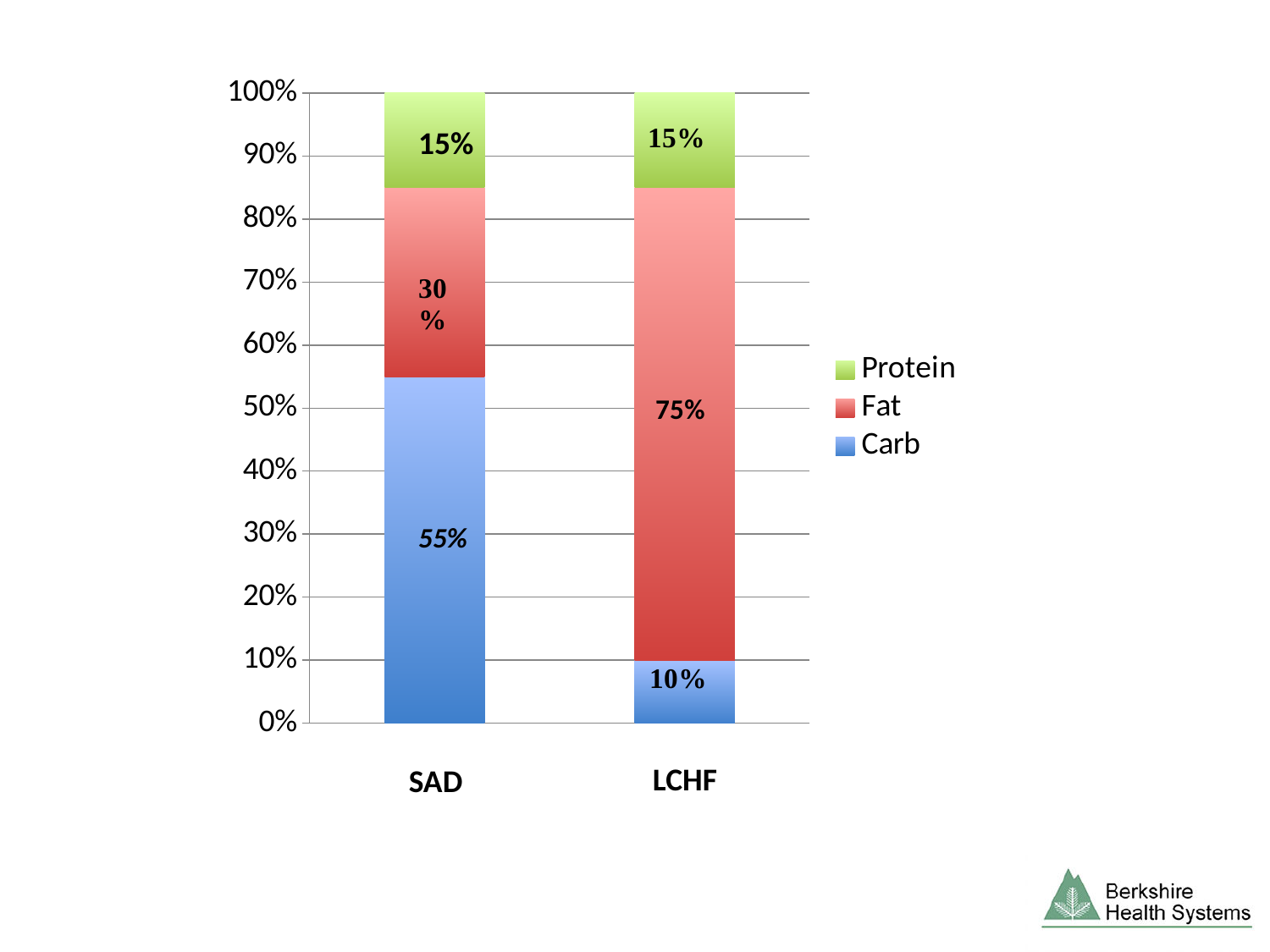
What is the Fat value for SAD? 30% What is the Carb value for SAD? 55% How many series does the legend list? 3 How many categories are shown on the x axis? 2 What is the Carb value for LCHF? 10% What is the difference between the Carb values for SAD and LCHF? 45% Which category has the lower Carb value? LCHF What is the Fat value for LCHF? 75% What kind of chart is shown on the slide? Stacked bar chart What is the difference between the Fat values for LCHF and SAD? 45% What is the Protein value for LCHF? 15% Which category has the higher Fat value, SAD or LCHF? LCHF